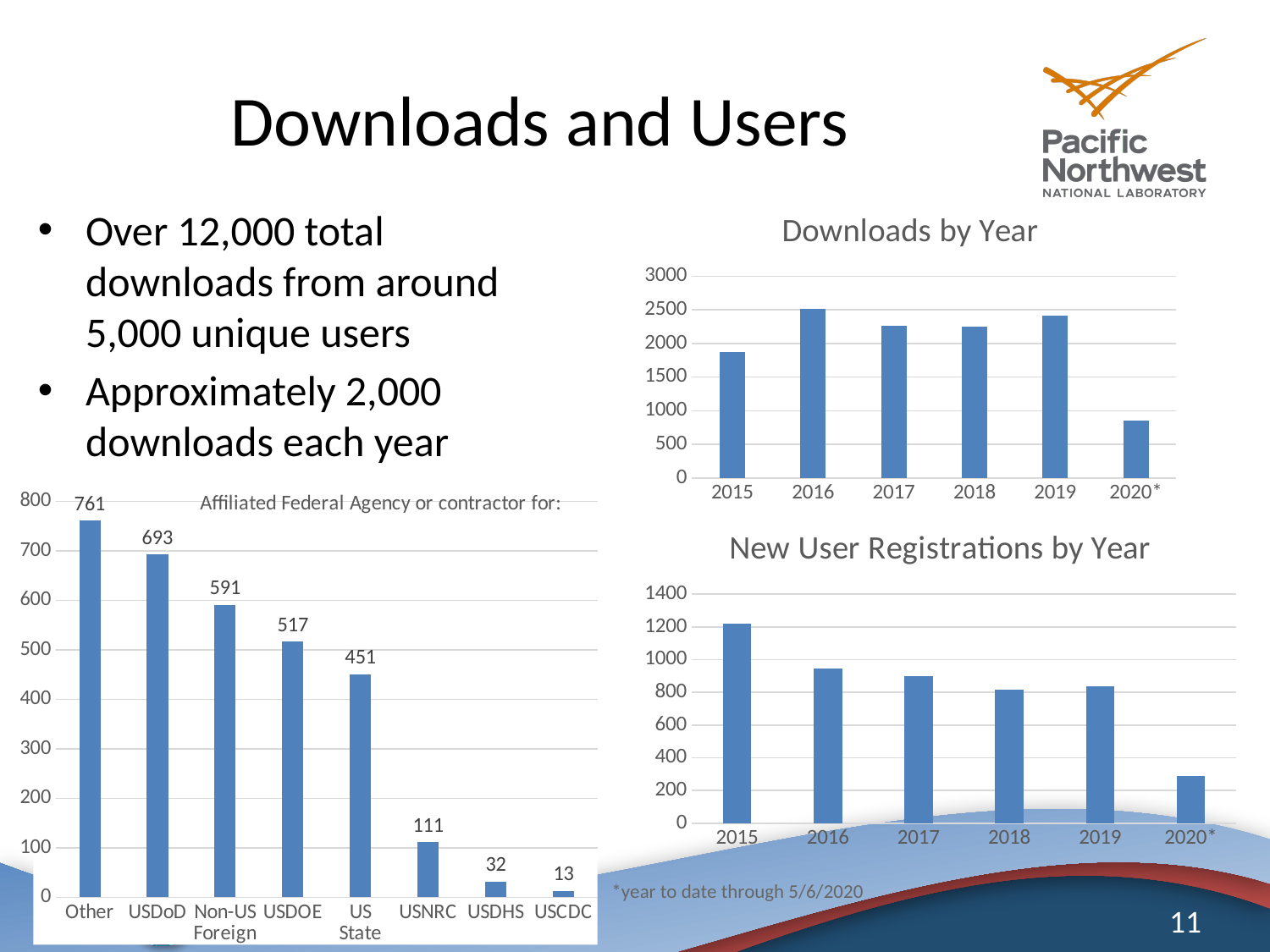
In the 'Downloads by Year' chart, which year has the highest value? 2016 In the 'Affiliated Federal Agency or contractor for:' chart, what is the value for USDoD? 693 In the 'Affiliated Federal Agency or contractor for:' chart, what is the value for Non-US Foreign? 591 What kind of chart is 'New User Registrations by Year'? bar chart In the 'Downloads by Year' chart, is the value for 2015 greater or less than 2000? less In the 'Affiliated Federal Agency or contractor for:' chart, how many categories are shown? 8 In the 'New User Registrations by Year' chart, which is larger, 2016 or 2018? 2016 In the 'Affiliated Federal Agency or contractor for:' chart, which category has the highest value? Other In the 'Affiliated Federal Agency or contractor for:' chart, what is the difference between USDOE and US State? 66 In the 'Downloads by Year' chart, is the value for 2020* greater or less than 500? greater In the 'Affiliated Federal Agency or contractor for:' chart, which category has the lowest value? USCDC